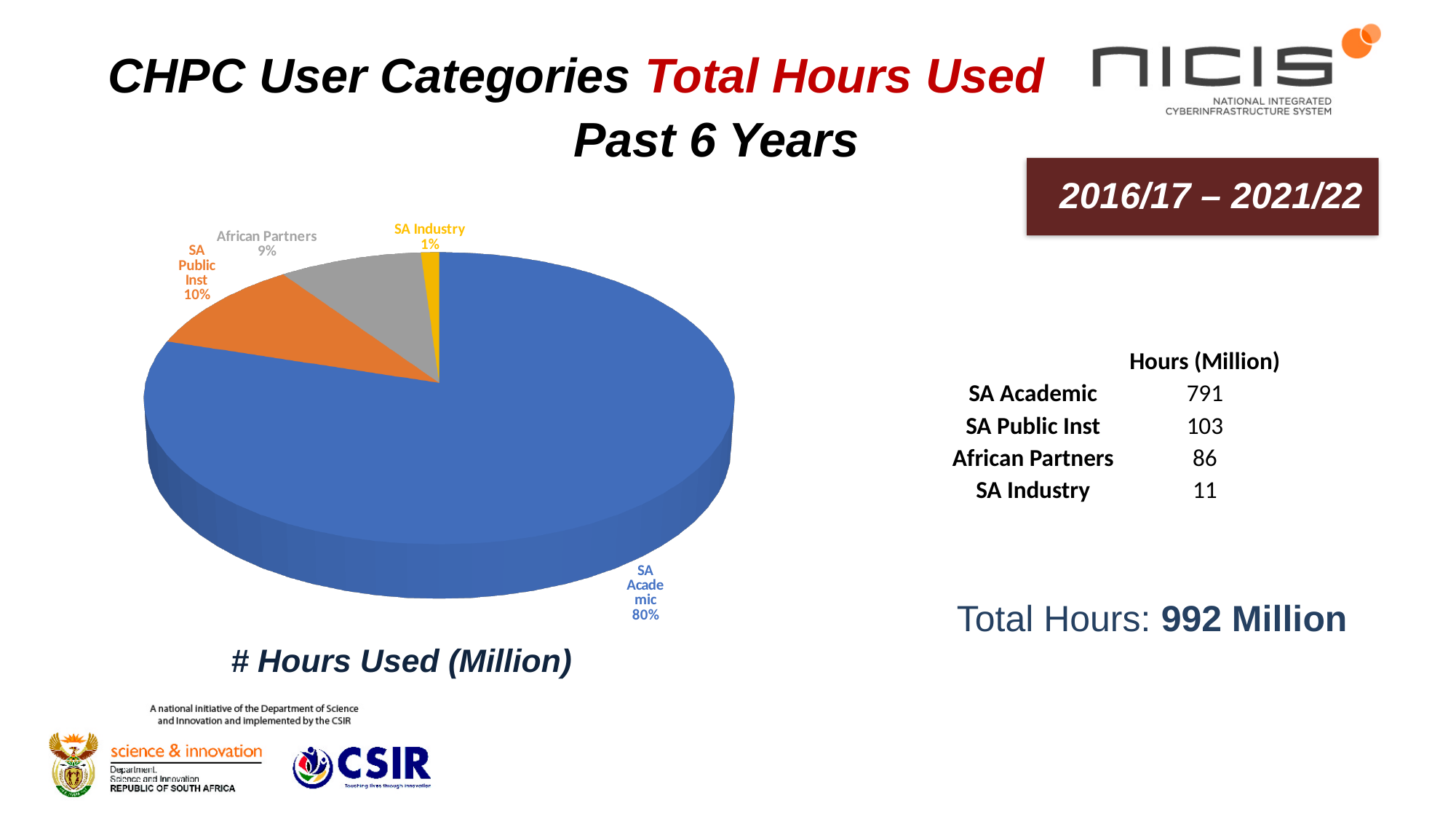
What kind of chart is shown on the slide? pie chart What share of the pie does SA Academic account for? 80% Which slice is larger, SA Public Inst or African Partners? SA Public Inst How many million hours were used by SA Academic, according to the table next to the chart? 791 What share of the pie does SA Public Inst account for? 10% How many categories does the pie chart show? 4 Which category has the smallest slice of the pie? SA Industry What share of the pie does SA Industry account for? 1% What is the title shown below the pie chart? # Hours Used (Million) Which category has the largest slice of the pie? SA Academic What is the difference in hours (million) between SA Public Inst and African Partners, according to the table? 17